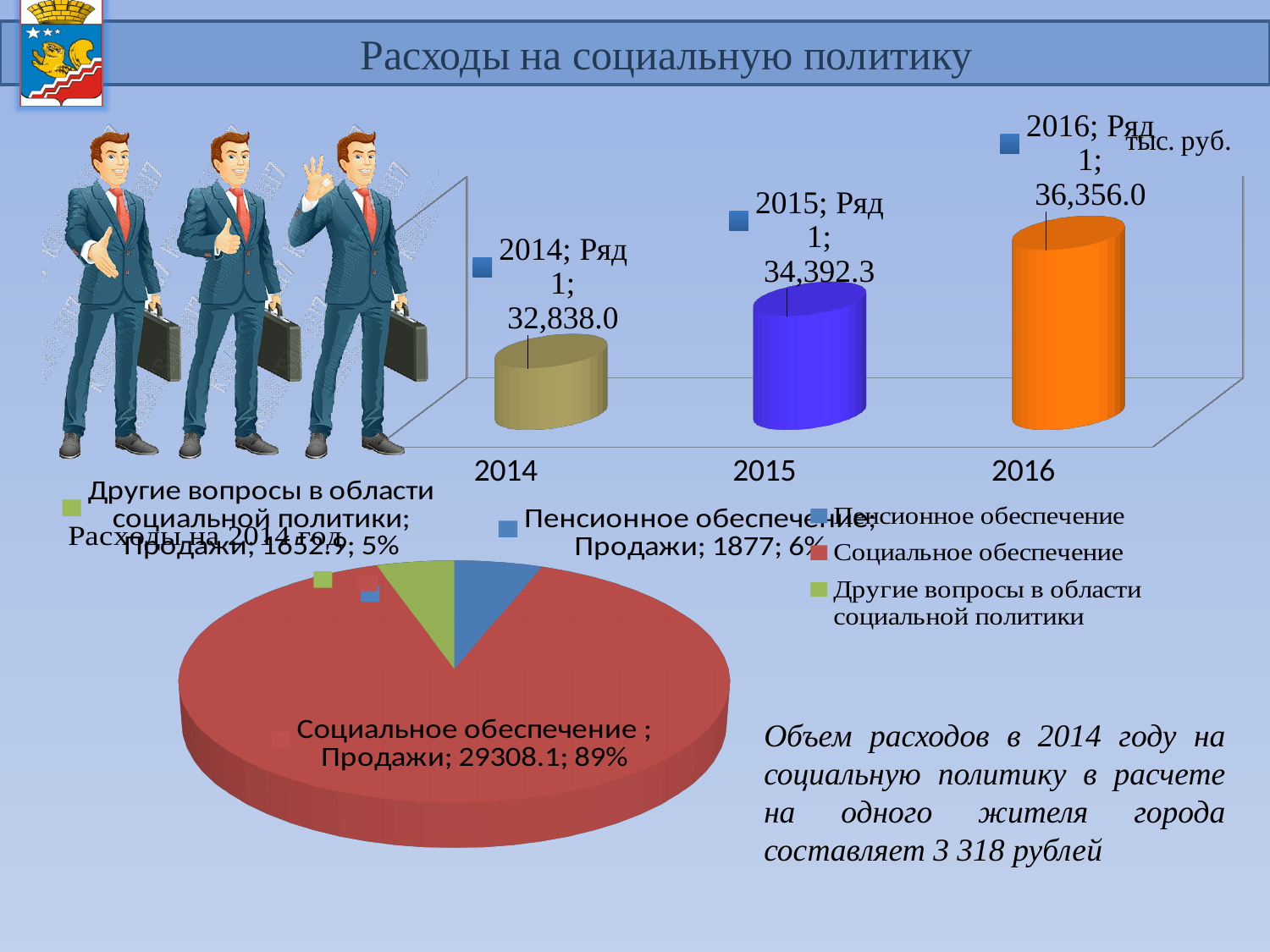
In the top bar chart, which year has the lowest value? 2014 In the pie chart 'Расходы на 2014 год', how many entries does the legend list? 3 In the top bar chart, what is the value for 2016? 36,356.0 In the top bar chart, what unit is shown in the upper right corner? тыс. руб. In the top bar chart, what is the value for 2014? 32,838.0 In the top bar chart, which year has the highest value? 2016 In the top bar chart, what is the value for 2015? 34,392.3 In the top bar chart, how many years are plotted? 3 In the pie chart 'Расходы на 2014 год', what is the value for Другие вопросы в области социальной политики? 1652.9 In the pie chart 'Расходы на 2014 год', what is the value for Пенсионное обеспечение? 1877 In the pie chart 'Расходы на 2014 год', what share does Социальное обеспечение have? 89% In the top bar chart, do the values rise or fall from 2014 to 2016? rise